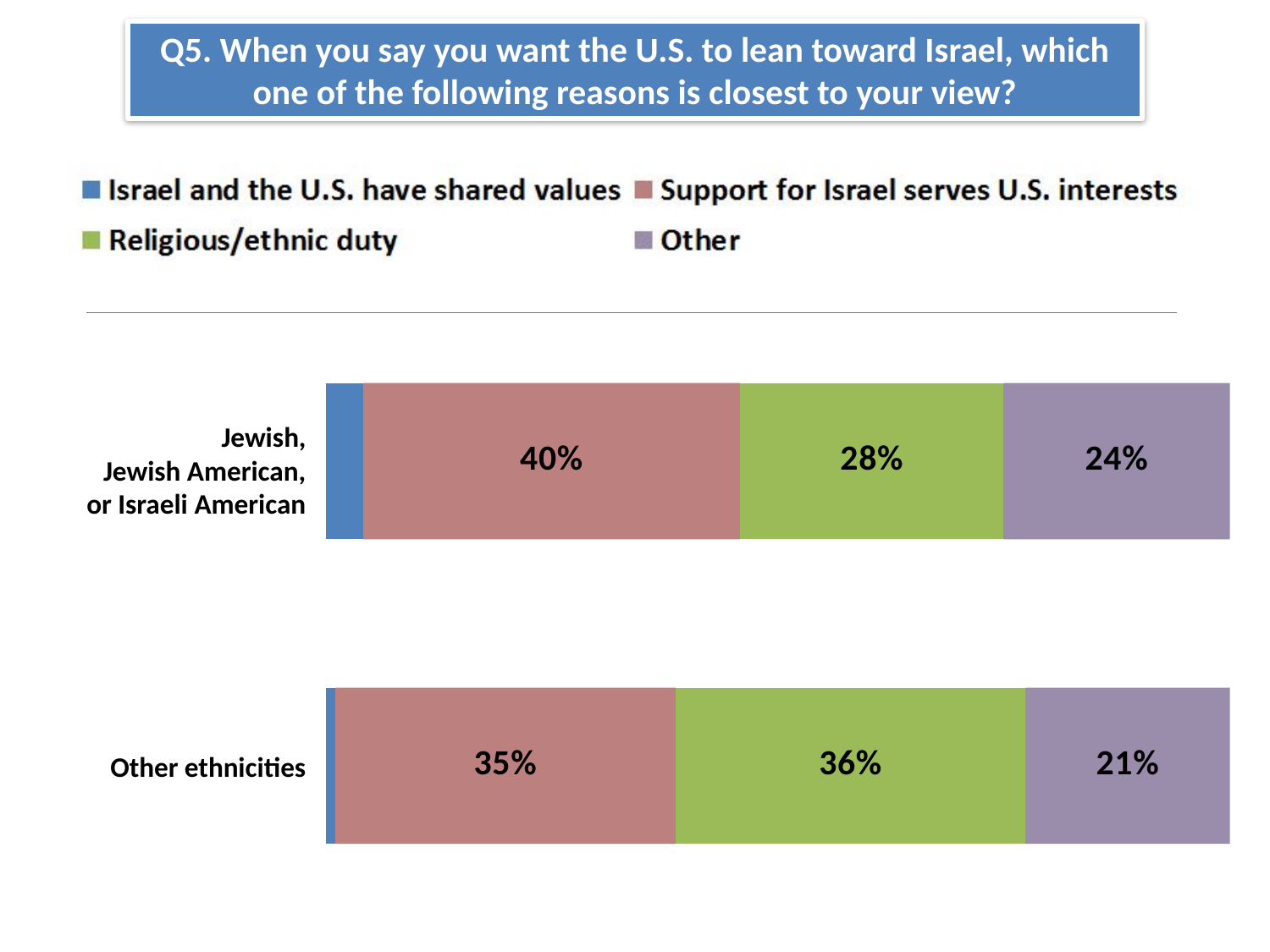
What kind of chart is shown on the slide? Stacked bar chart How many series does the legend list? 4 Which colour represents "Religious/ethnic duty" in the chart? Green Which group has a larger share for "Other": Jewish, Jewish American, or Israeli American, or Other ethnicities? Jewish, Jewish American, or Israeli American What is the difference between the "Religious/ethnic duty" shares for Other ethnicities and for the Jewish, Jewish American, or Israeli American group? 8% Which reason has the smallest share in the Other ethnicities bar? Israel and the U.S. have shared values What percentage of the Jewish, Jewish American, or Israeli American group chose "Other"? 24% What percentage of the Jewish, Jewish American, or Israeli American group chose "Support for Israel serves U.S. interests"? 40% How many groups (bars) are shown in the chart? 2 What percentage of the Other ethnicities group chose "Support for Israel serves U.S. interests"? 35% Which reason has the largest share in the Jewish, Jewish American, or Israeli American bar? Support for Israel serves U.S. interests What percentage of the Other ethnicities group chose "Religious/ethnic duty"? 36%